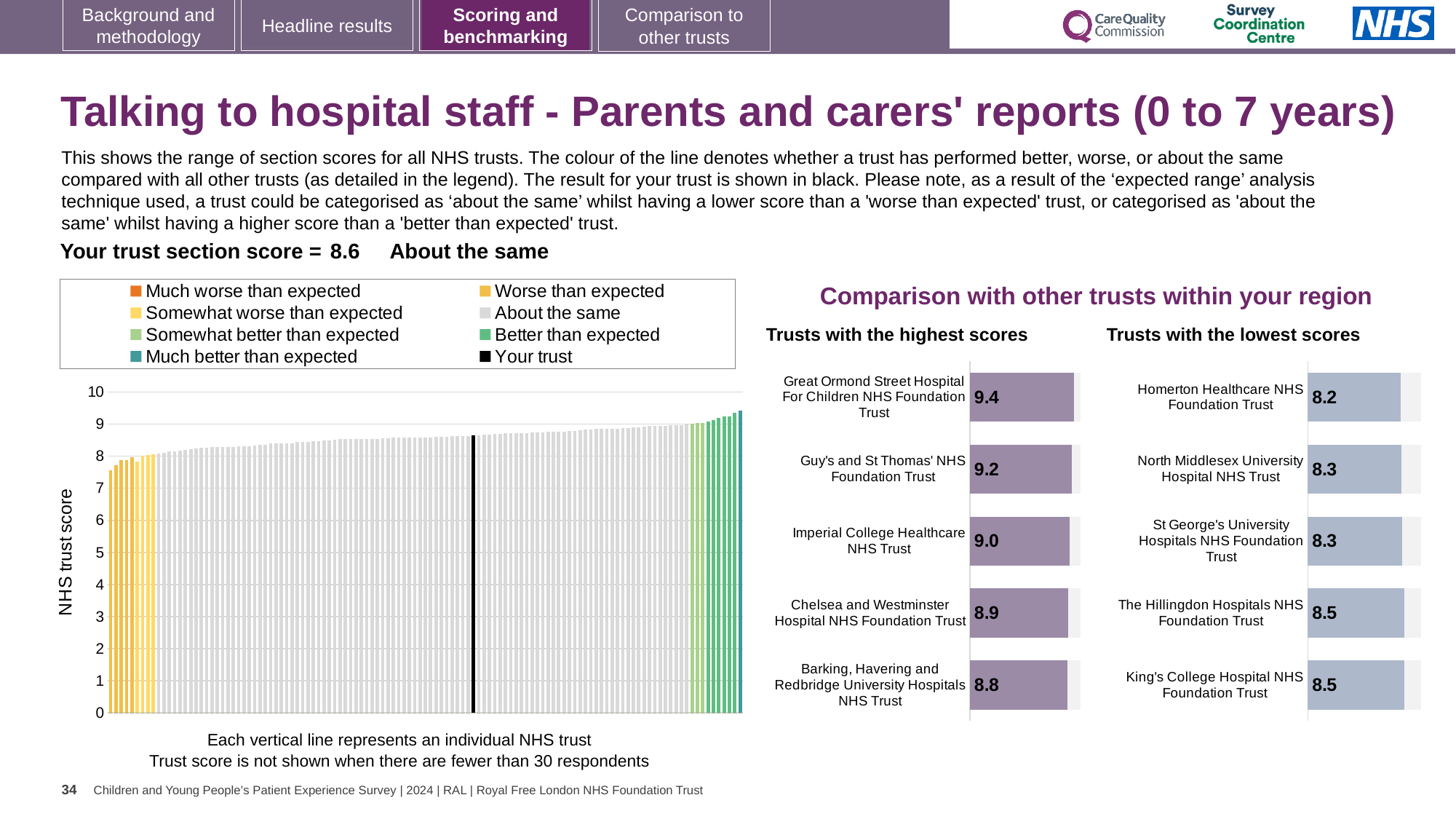
In the NHS trust score chart on the left, do the values rise or fall from left to right? Rise In the NHS trust score chart on the left, is the value for your trust (the black line) greater or less than 8? greater In the 'Trusts with the lowest scores' chart, which trust has the lowest score? Homerton Healthcare NHS Foundation Trust In the 'Trusts with the highest scores' chart, which has the higher score: Imperial College Healthcare NHS Trust or Chelsea and Westminster Hospital NHS Foundation Trust? Imperial College Healthcare NHS Trust In the 'Trusts with the highest scores' chart, which trust has the highest score? Great Ormond Street Hospital For Children NHS Foundation Trust In the 'Trusts with the lowest scores' chart, what is the difference between the scores of The Hillingdon Hospitals NHS Foundation Trust and Homerton Healthcare NHS Foundation Trust? 0.3 In the 'Trusts with the highest scores' chart, what is the score for Great Ormond Street Hospital For Children NHS Foundation Trust? 9.4 What kind of chart is the NHS trust score chart on the left of the slide? Bar chart In the 'Trusts with the highest scores' chart, what is the difference between the scores of Great Ormond Street Hospital For Children NHS Foundation Trust and Barking, Havering and Redbridge University Hospitals NHS Trust? 0.6 How many trusts are shown in the 'Trusts with the lowest scores' chart? 5 In the 'Trusts with the lowest scores' chart, what is the score for Homerton Healthcare NHS Foundation Trust? 8.2 How many entries does the legend of the NHS trust score chart on the left list? 8